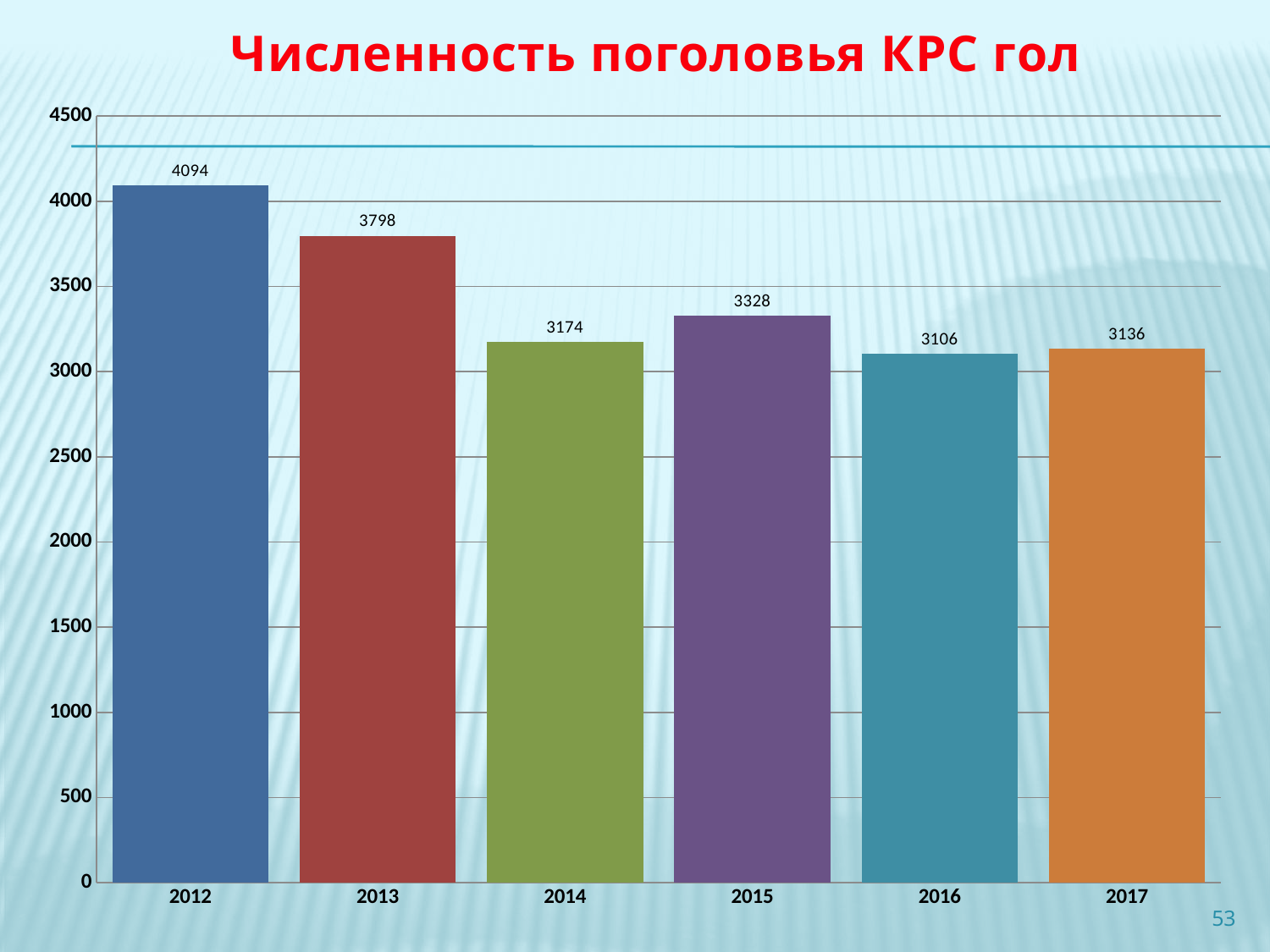
What is the title of the chart? Численность поголовья КРС гол What is the value for 2012? 4094 What is the value for 2017? 3136 How many years are shown on the x axis? 6 Which year has the lowest value? 2016 What kind of chart is this? bar chart Is the value for 2013 greater or less than 3500? greater What is the difference between the values for 2012 and 2013? 296 Which is larger, the value for 2014 or the value for 2015? 2015 Which year has the highest value? 2012 What is the difference between the values for 2017 and 2016? 30 What is the value for 2015? 3328